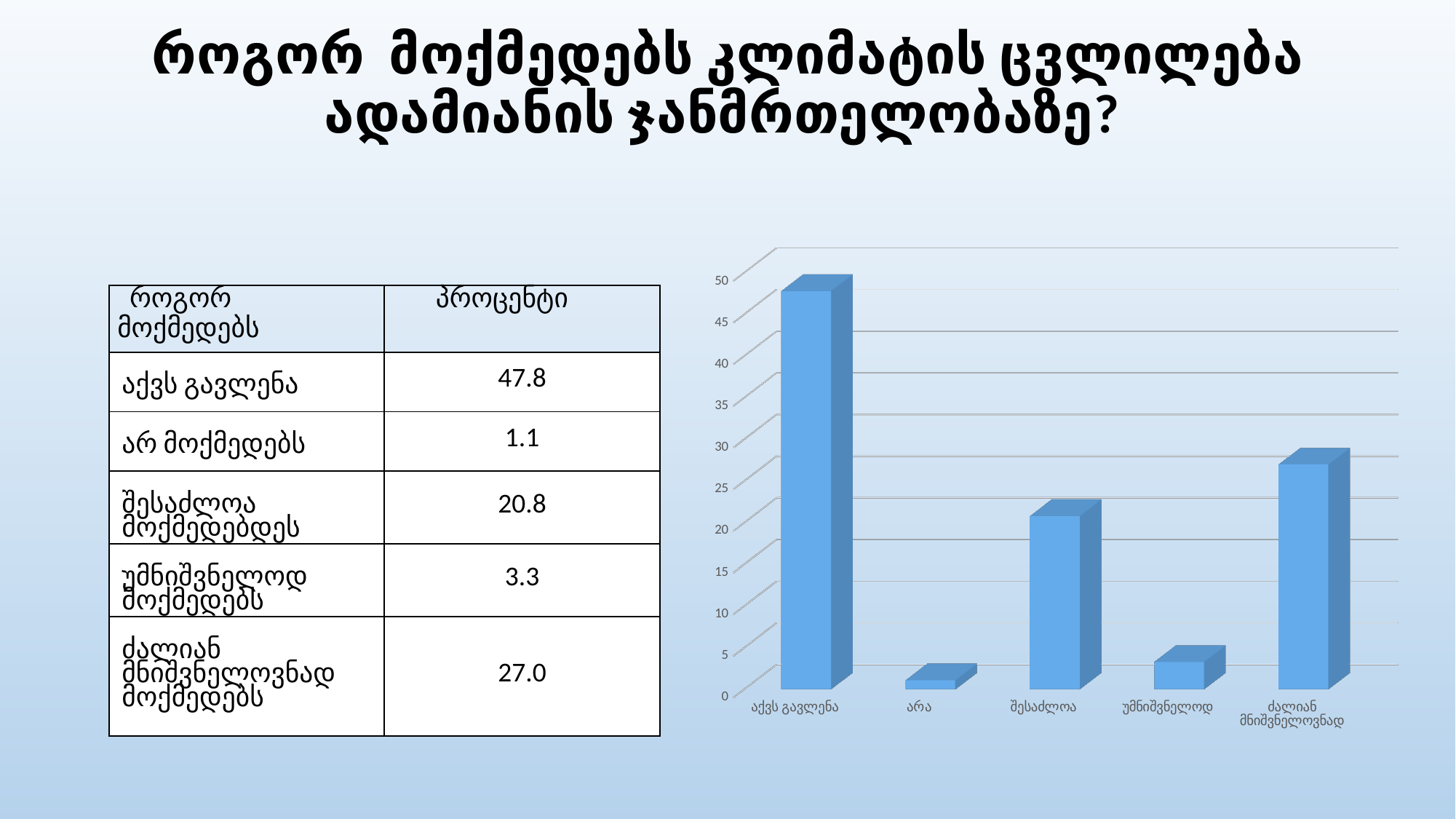
According to the table on the slide, what is the percentage for ძალიან მნიშვნელოვნად მოქმედებს? 27.0 Which is larger in the chart: the bar for შესაძლოა or the bar for ძალიან მნიშვნელოვნად? ძალიან მნიშვნელოვნად According to the table on the slide, what is the percentage for შესაძლოა მოქმედებდეს? 20.8 Which category has the highest bar in the chart? აქვს გავლენა How many categories does the bar chart show? 5 What kind of chart is shown on the slide? bar chart According to the table on the slide, what is the percentage for აქვს გავლენა? 47.8 Is the value for უმნიშვნელოდ in the chart greater or less than 5? less Is the value for ძალიან მნიშვნელოვნად in the chart greater or less than 25? greater Which category has the lowest bar in the chart? არა Using the values in the table, what is the difference between აქვს გავლენა (47.8) and ძალიან მნიშვნელოვნად მოქმედებს (27.0)? 20.8 Is the value for აქვს გავლენა in the chart greater or less than 45? greater